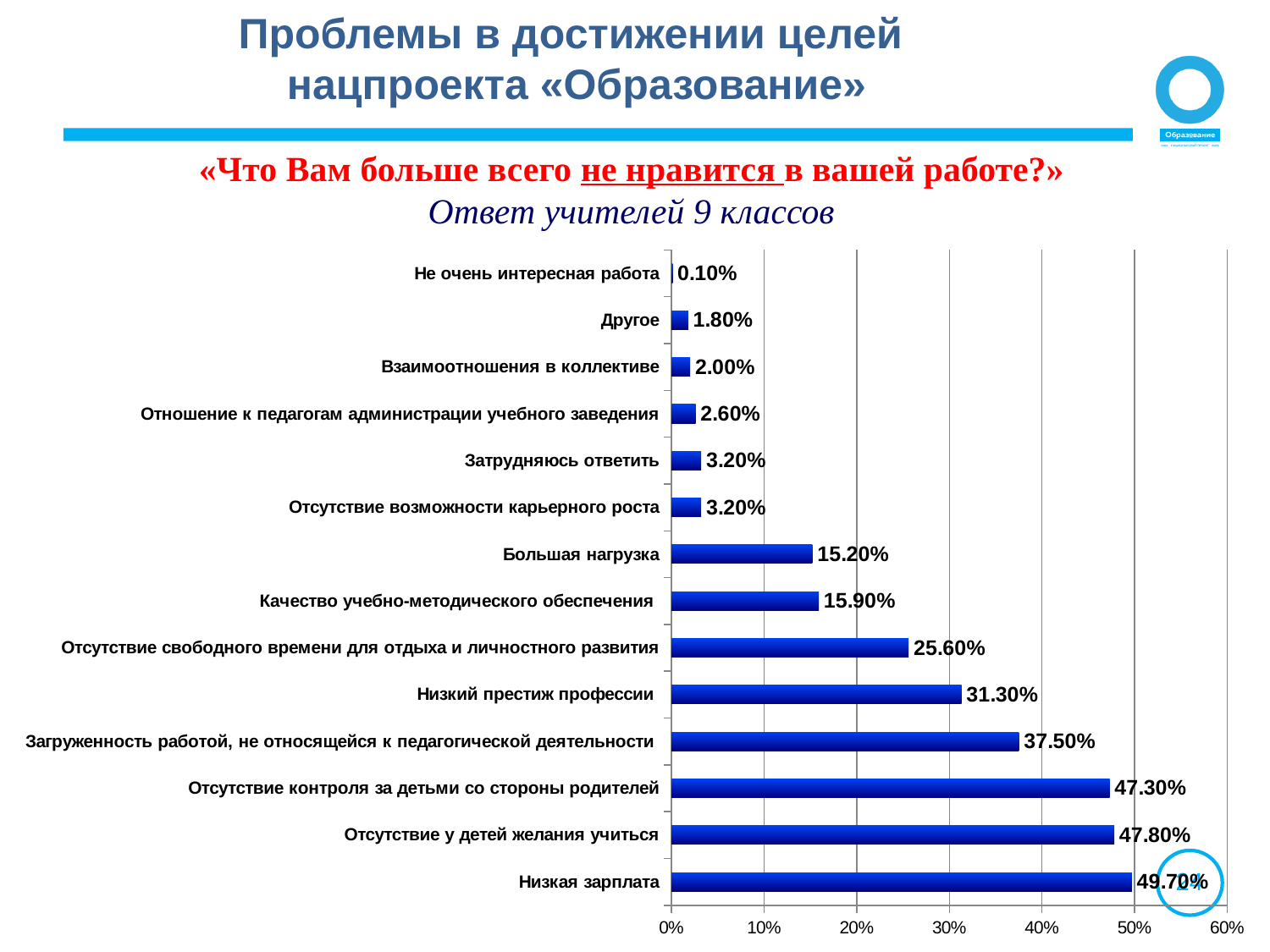
Which is larger: «Отсутствие контроля за детьми со стороны родителей» or «Низкий престиж профессии»? Отсутствие контроля за детьми со стороны родителей Is the value for «Низкий престиж профессии» greater or less than 30%? greater What is the difference between «Загруженность работой, не относящейся к педагогической деятельности» and «Низкий престиж профессии»? 6.20% What is the difference between «Низкая зарплата» and «Отсутствие у детей желания учиться»? 1.90% Which category has the highest value? Низкая зарплата Which category has the lowest value? Не очень интересная работа What is the value for «Низкая зарплата»? 49.70% What is the value for «Большая нагрузка»? 15.20% What kind of chart is shown on the slide? bar chart How many categories are shown in the chart? 14 What is the value for «Отсутствие свободного времени для отдыха и личностного развития»? 25.60% What is the value for «Другое»? 1.80%